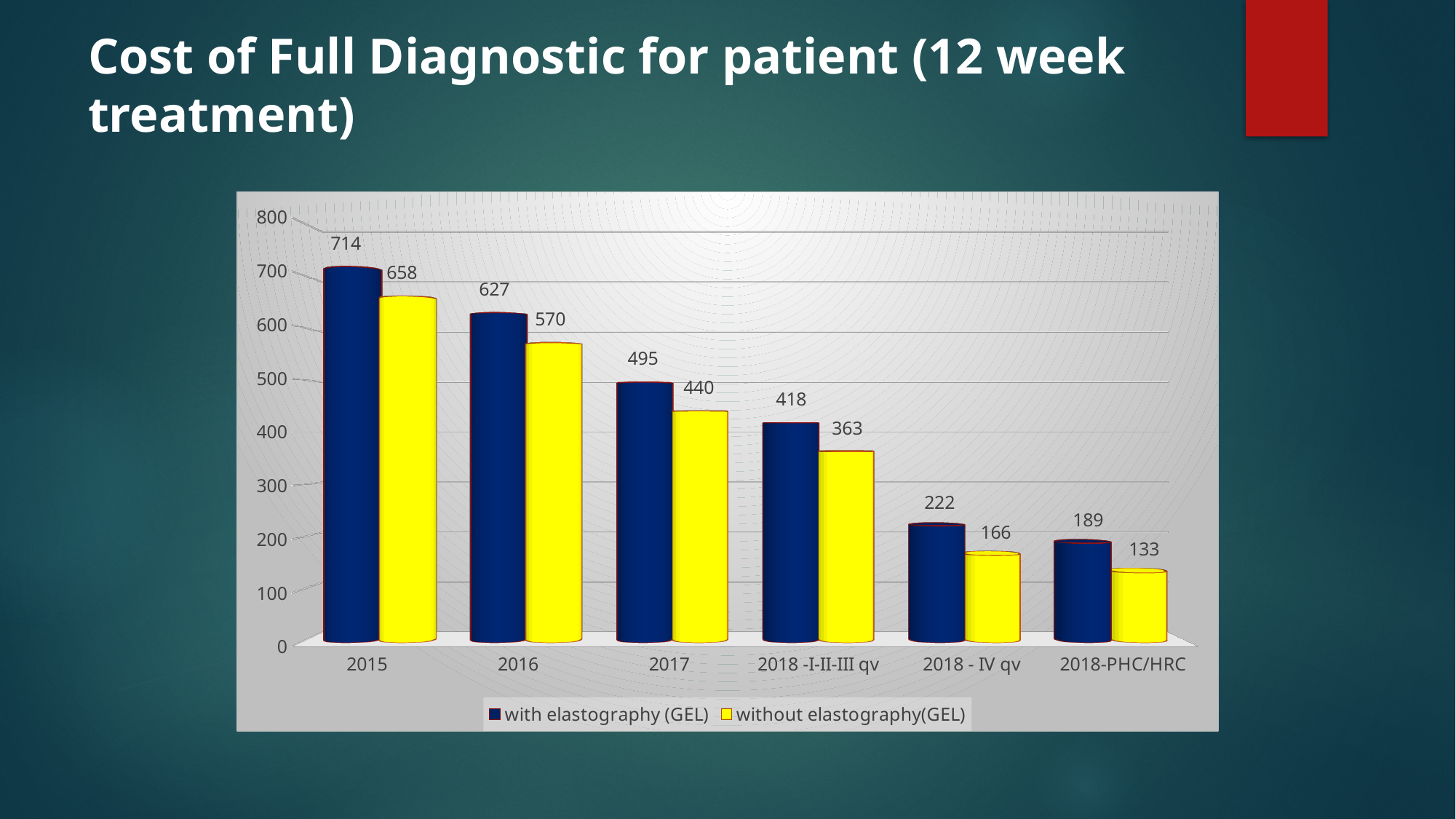
What is the value for 'without elastography(GEL)' in 2017? 440 What kind of chart is shown on the slide? bar chart What is the value for 'with elastography (GEL)' for 2018 - IV qv? 222 What is the difference between the 'with elastography (GEL)' and 'without elastography(GEL)' values in 2016? 57 What is the value for 'with elastography (GEL)' in 2015? 714 Which is larger: the 'with elastography (GEL)' value for 2018 -I-II-III qv or the 'without elastography(GEL)' value for 2017? without elastography(GEL) for 2017 Do the 'with elastography (GEL)' values rise or fall from left to right along the x axis? fall What colour are the bars for 'without elastography(GEL)'? yellow How many categories are shown on the x axis? 6 Which category has the highest value for 'with elastography (GEL)'? 2015 How many series does the legend list? 2 Which category has the lowest value for 'without elastography(GEL)'? 2018-PHC/HRC